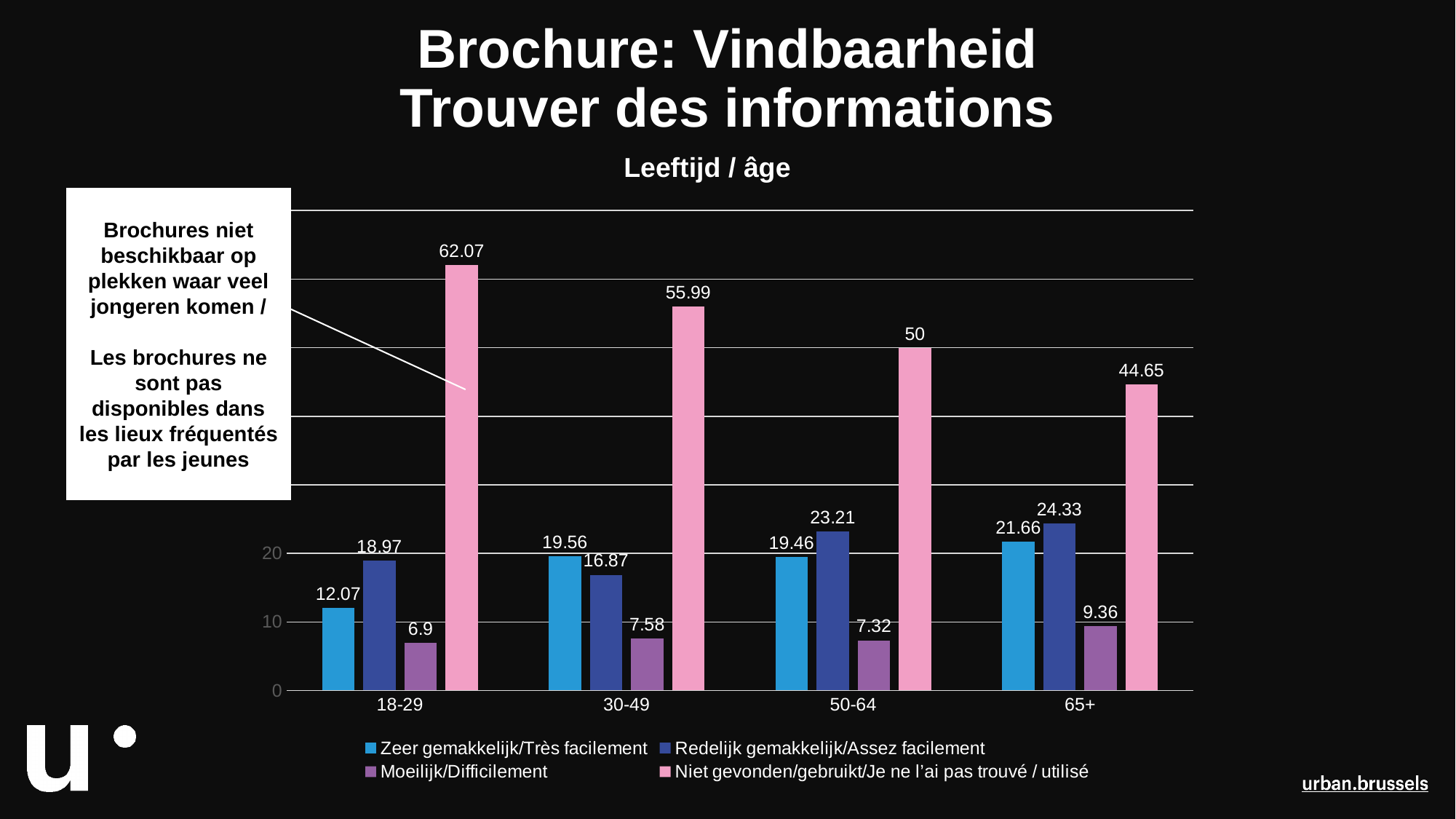
What is the value for 'Niet gevonden/gebruikt/Je ne l'ai pas trouvé / utilisé' in the 18-29 age group? 62.07 Is the value for 'Redelijk gemakkelijk/Assez facilement' in the 30-49 age group greater or less than 20? less What is the value for 'Moeilijk/Difficilement' in the 30-49 age group? 7.58 What kind of chart is shown on the slide? bar chart Which age group has the highest value for 'Niet gevonden/gebruikt/Je ne l'ai pas trouvé / utilisé'? 18-29 How many series does the legend list? 4 Do the values for 'Niet gevonden/gebruikt/Je ne l'ai pas trouvé / utilisé' rise or fall from 18-29 to 65+? fall Which is larger in the 50-64 age group: 'Zeer gemakkelijk/Très facilement' or 'Redelijk gemakkelijk/Assez facilement'? Redelijk gemakkelijk/Assez facilement Which age group has the lowest value for 'Zeer gemakkelijk/Très facilement'? 18-29 How many age groups are shown on the x axis? 4 What is the value for 'Zeer gemakkelijk/Très facilement' in the 65+ age group? 21.66 What is the difference between the 'Niet gevonden/gebruikt/Je ne l'ai pas trouvé / utilisé' values for 18-29 and 65+? 17.42